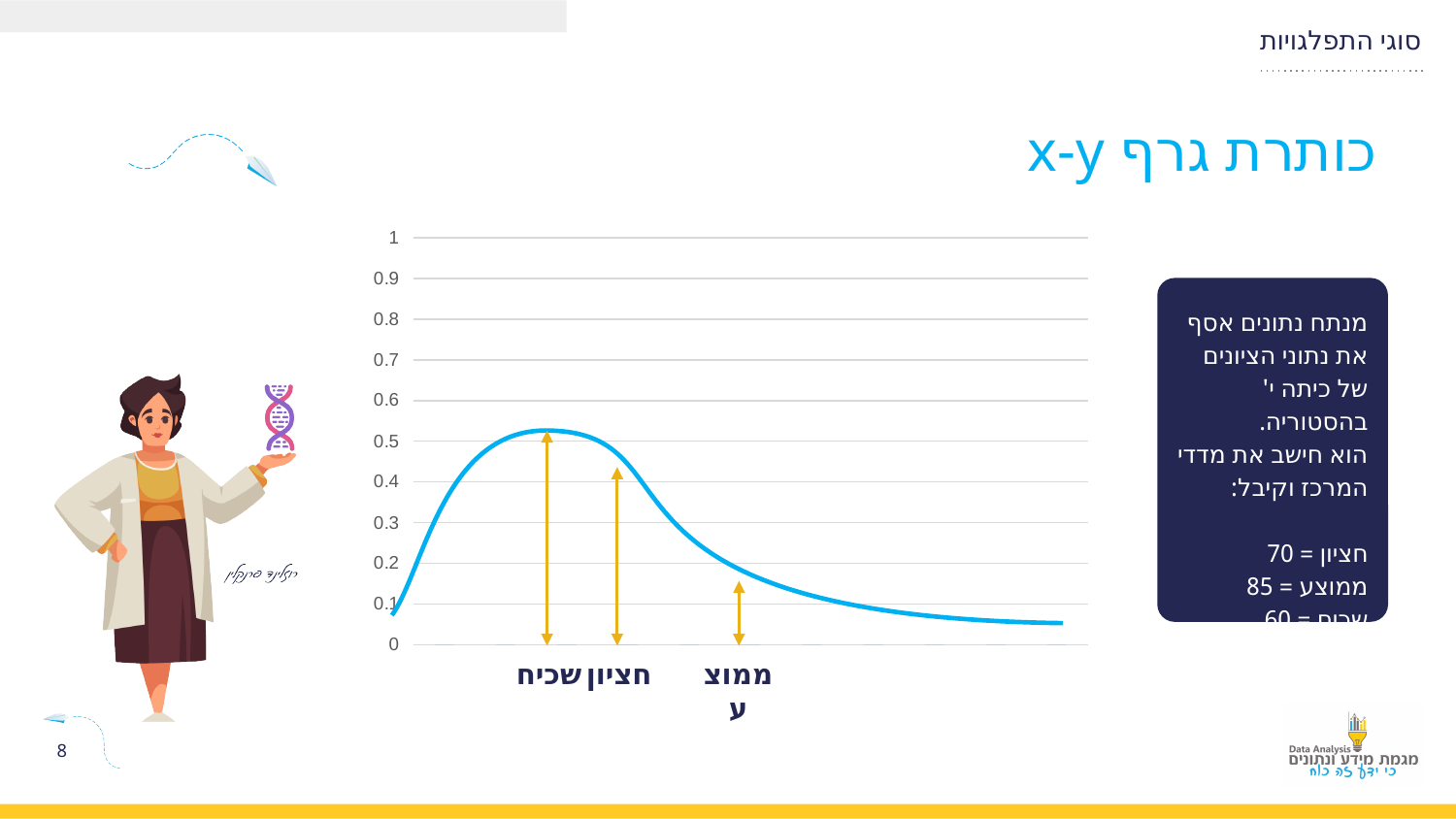
Reading the x-axis labels from left to right, which label comes first? שכיח Is the curve value at חציון greater or less than 0.3? greater Is the curve value at חציון greater or less than the curve value at ממוצע? greater How many labelled points (arrows) are marked along the x axis of the chart? 3 Is the curve value at ממוצע greater or less than 0.2? less What is the title of the chart? כותרת גרף x-y What is the highest value shown on the y axis of the chart? 1 Is the peak value of the curve greater or less than 0.6? less Does the curve rise or fall as it moves from חציון to ממוצע along the x axis? fall Which labelled point on the x axis is located at the peak of the curve? שכיח Which of the three labelled points (שכיח, חציון, ממוצע) has the lowest curve value? ממוצע What kind of chart is shown on the slide? line chart